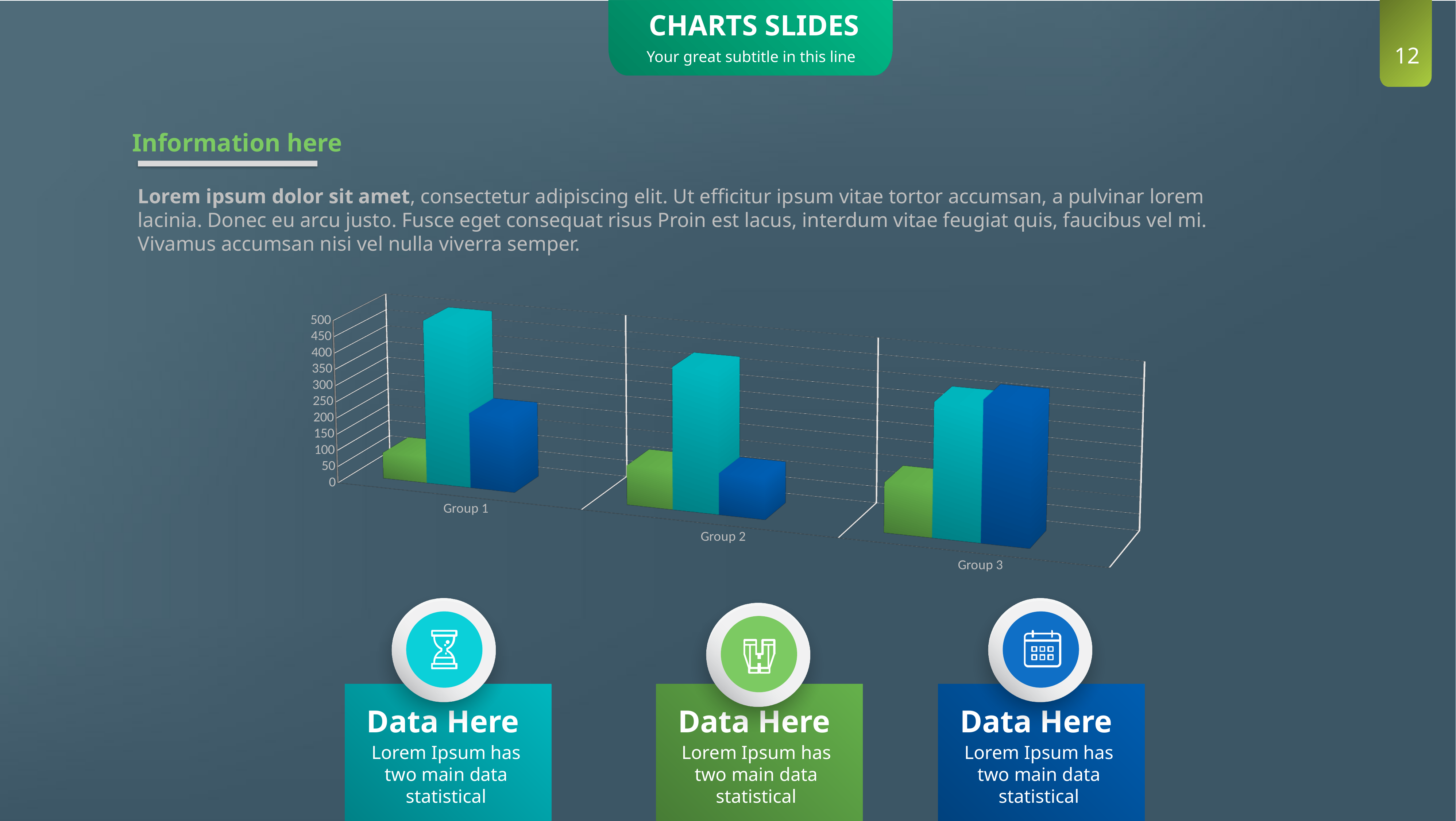
Which is larger: the cyan bar in Group 1 or the cyan bar in Group 2? the cyan bar in Group 1 What kind of chart is shown on the slide? bar chart What are the category labels along the x axis of the chart? Group 1, Group 2, Group 3 In Group 1, which bar is the shortest: the green, the cyan or the dark blue one? green Is the value of the cyan bar in Group 1 greater or less than 400? greater How many bars are plotted for each group in the chart? 3 Is the value of the green bar in Group 1 greater or less than 200? less Is the value of the dark blue bar in Group 2 greater or less than 200? less What is the highest value shown on the chart's vertical axis? 500 How many groups (categories) are shown on the x axis of the chart? 3 In Group 2, which is larger: the cyan bar or the green bar? the cyan bar Which group contains the tallest bar in the chart? Group 1